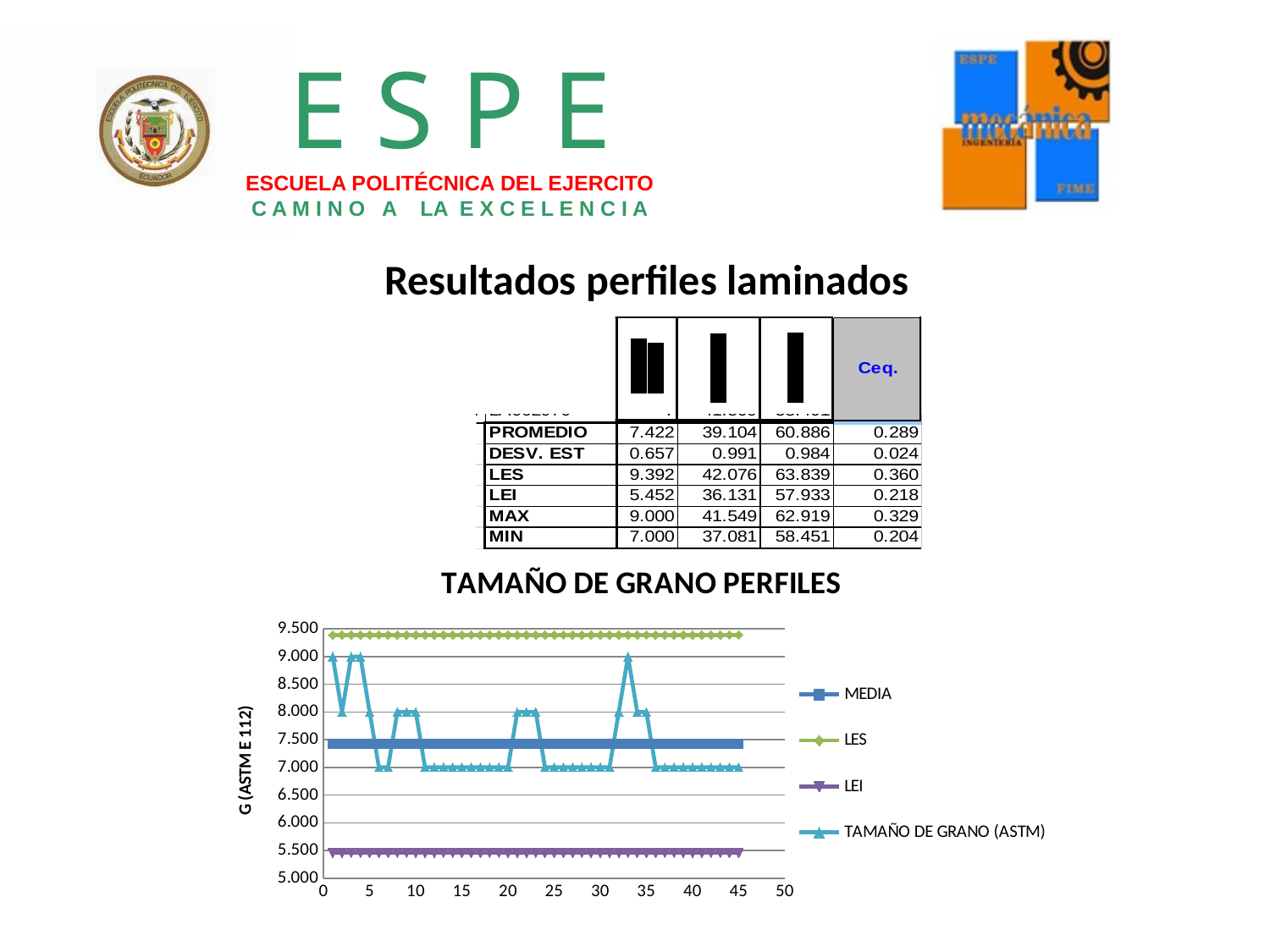
In the TAMAÑO DE GRANO PERFILES chart, does the LES series rise, fall or stay flat along the x axis? stay flat In the TAMAÑO DE GRANO PERFILES chart, which series lies lowest on the y axis? LEI How many series does the legend of the TAMAÑO DE GRANO PERFILES chart list? 4 In the TAMAÑO DE GRANO PERFILES chart, which series lies highest on the y axis? LES In the TAMAÑO DE GRANO PERFILES chart, is the MEDIA line greater or less than 7.000? greater What is the label on the y axis of the TAMAÑO DE GRANO PERFILES chart? G (ASTM E 112) What kind of chart is shown under the heading TAMAÑO DE GRANO PERFILES? line chart In the TAMAÑO DE GRANO PERFILES chart, is the LES line greater or less than 9.000? greater In the TAMAÑO DE GRANO PERFILES chart, what is the lowest value reached by the TAMAÑO DE GRANO (ASTM) series? 7.000 In the TAMAÑO DE GRANO PERFILES chart, which series has larger values, LES or LEI? LES In the TAMAÑO DE GRANO PERFILES chart, is the LEI line greater or less than 6.000? less In the TAMAÑO DE GRANO PERFILES chart, what is the highest value reached by the TAMAÑO DE GRANO (ASTM) series? 9.000